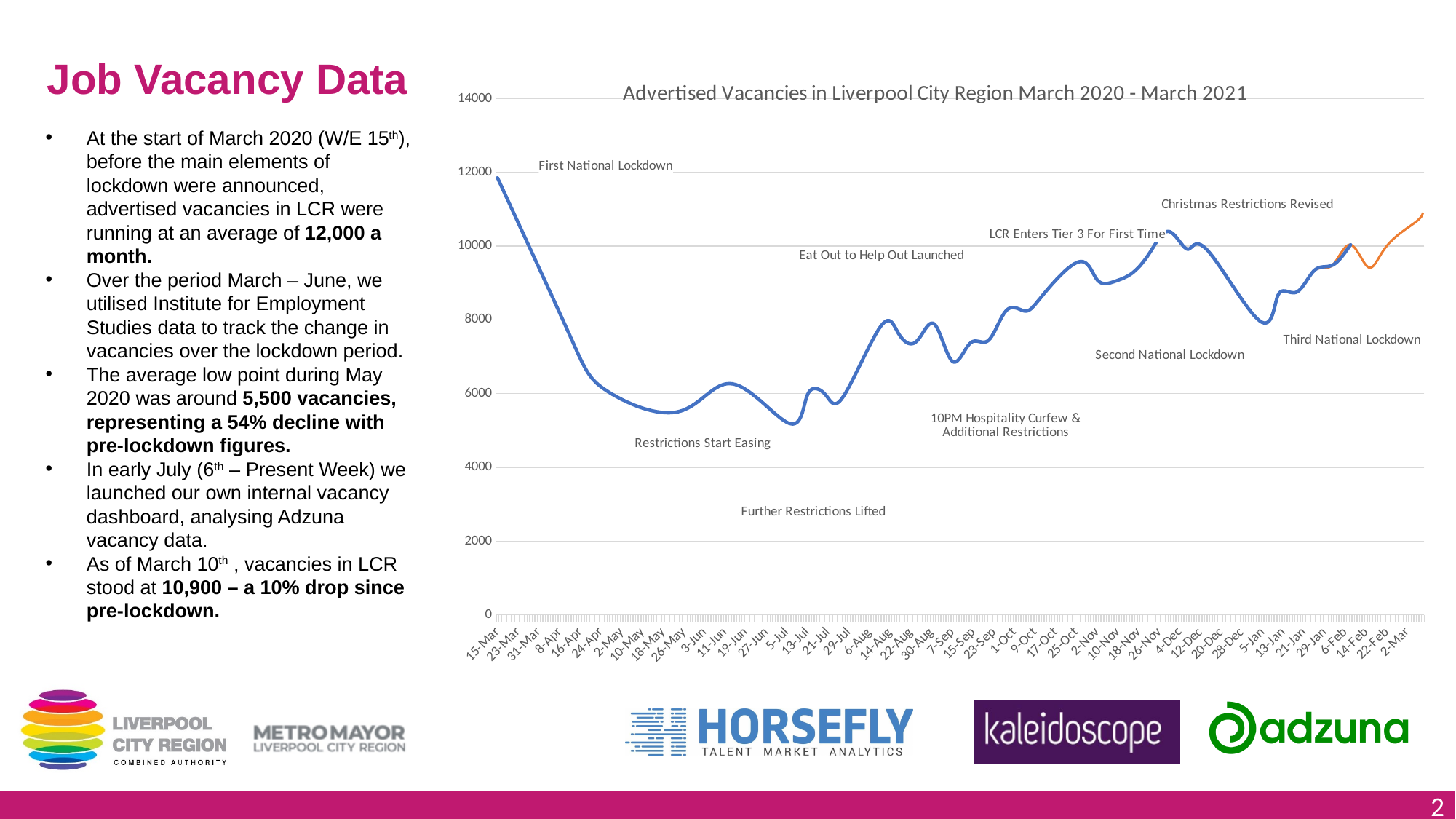
What is the highest value shown on the vertical axis? 14000 Is the value for 5-Jan greater or less than 10000? less Is the value for 18-May greater or less than 6000? less Which is larger, the value for 2-Mar or the value for 5-Jan? 2-Mar Is the value for 2-Mar greater or less than 10000? greater Which is larger, the value for 15-Mar or the value for 18-May? 15-Mar Do advertised vacancies rise or fall overall between 5-Jul and 26-Nov? rise Do advertised vacancies rise or fall between 15-Mar and 18-May? fall What is the title of the chart? Advertised Vacancies in Liverpool City Region March 2020 - March 2021 What kind of chart is shown on the slide? line chart